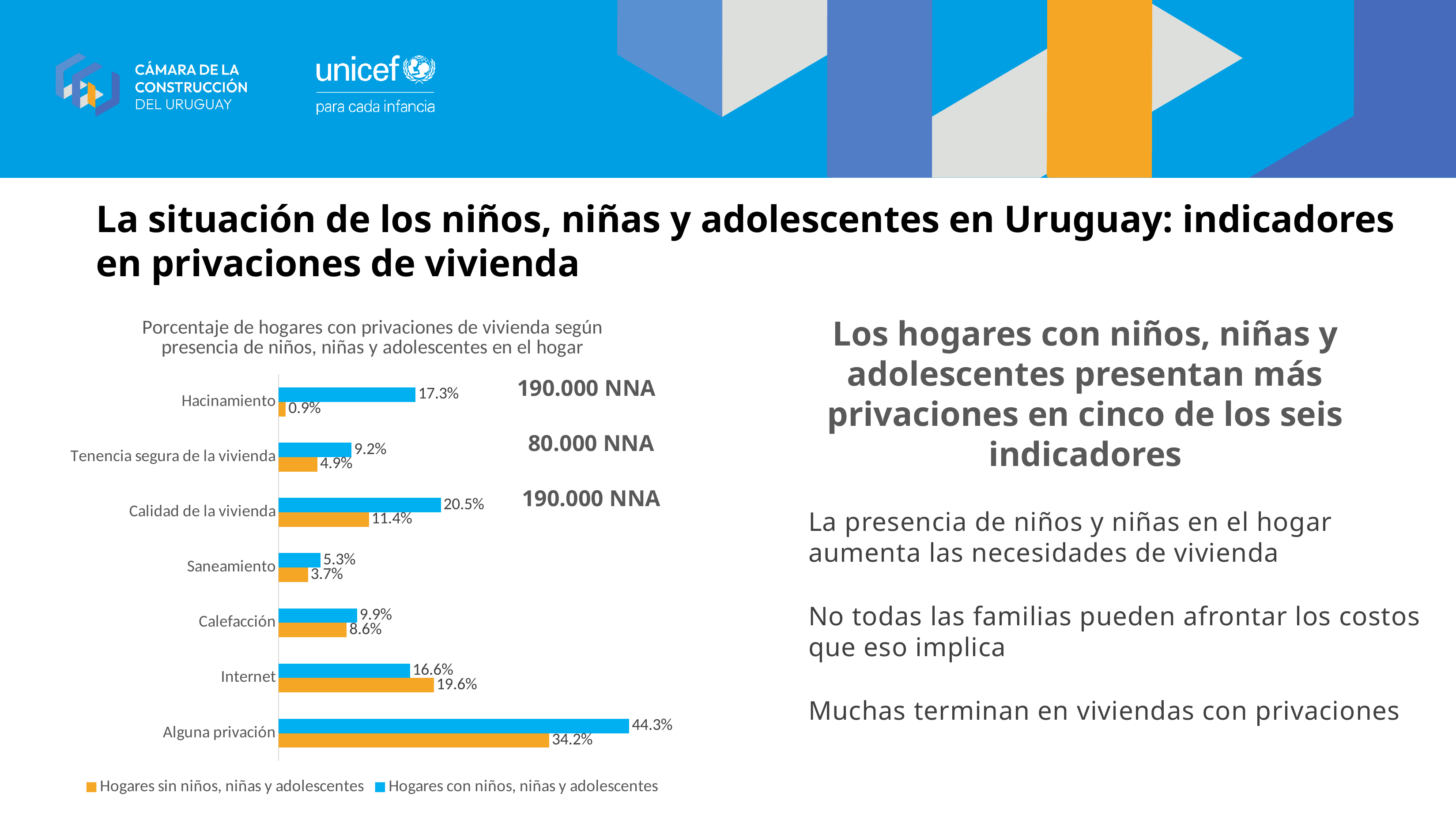
How many categories are shown on the chart? 7 What is the difference between the two series for Alguna privación? 10.1% What is the value for Hacinamiento in the series Hogares con niños, niñas y adolescentes? 17.3% Which category has the highest value in the series Hogares con niños, niñas y adolescentes? Alguna privación How many series does the legend list? 2 What is the value for Saneamiento in the series Hogares sin niños, niñas y adolescentes? 3.7% For Internet, which series has the larger value? Hogares sin niños, niñas y adolescentes What colour represents the series Hogares con niños, niñas y adolescentes? Blue Which category has the lowest value in the series Hogares sin niños, niñas y adolescentes? Hacinamiento What kind of chart is shown on the slide? Bar chart What is the value for Calidad de la vivienda in the series Hogares sin niños, niñas y adolescentes? 11.4% What is the value for Internet in the series Hogares sin niños, niñas y adolescentes? 19.6%